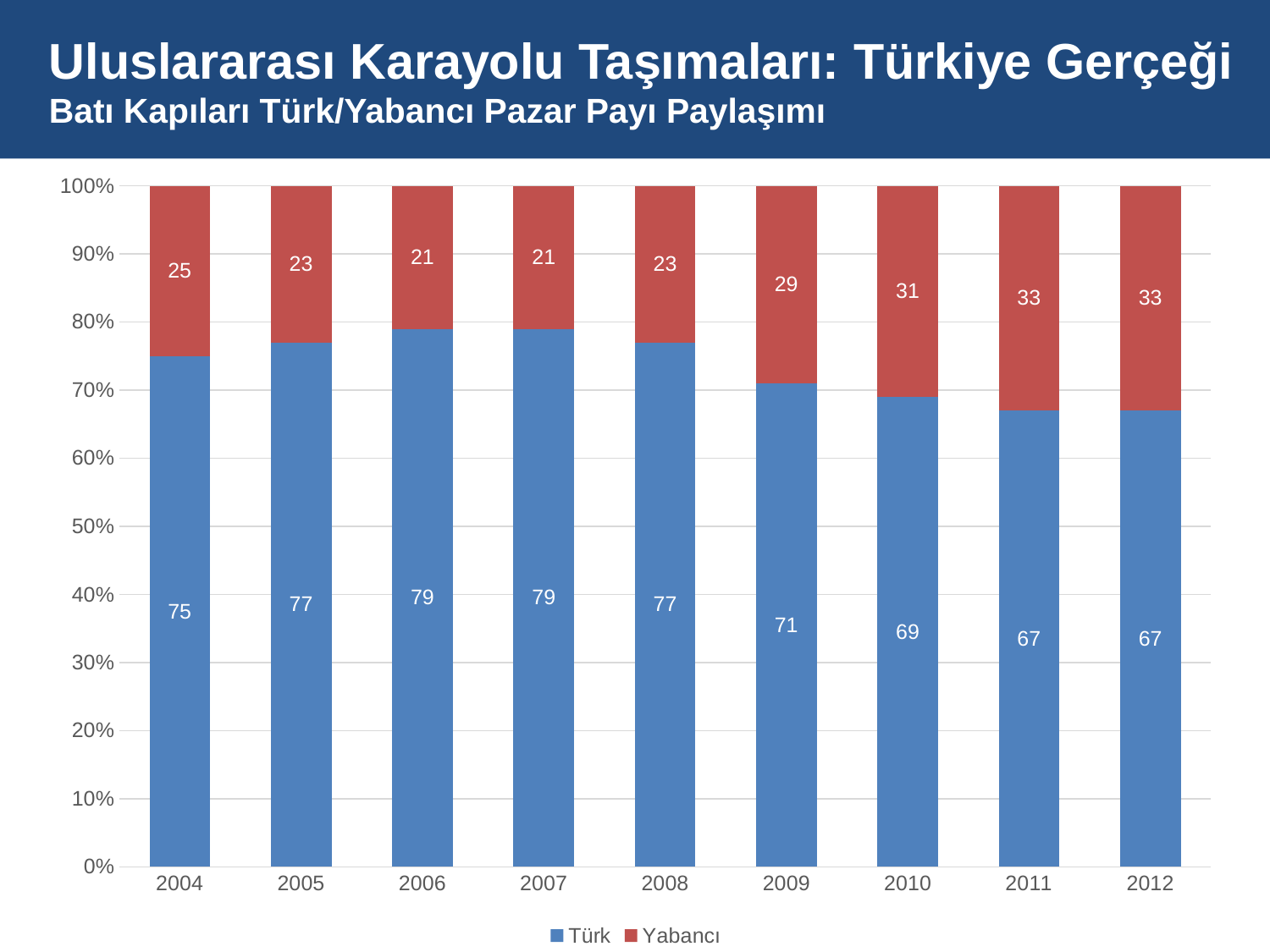
What is the Yabancı value for 2009? 29 What kind of chart is shown on the slide? Stacked bar chart How many series does the legend list? 2 Which series is shown in red? Yabancı Which year has the highest Türk value? 2006 and 2007 Which is larger, the Yabancı value for 2010 or the Yabancı value for 2005? 2010 What is the difference between the Türk value in 2004 and the Türk value in 2012? 8 Does the Türk value rise or fall from 2008 to 2012? Fall How many years are shown on the x axis? 9 What is the Yabancı value for 2012? 33 Which year has the lowest Yabancı value? 2006 and 2007 What is the Türk value for 2004? 75